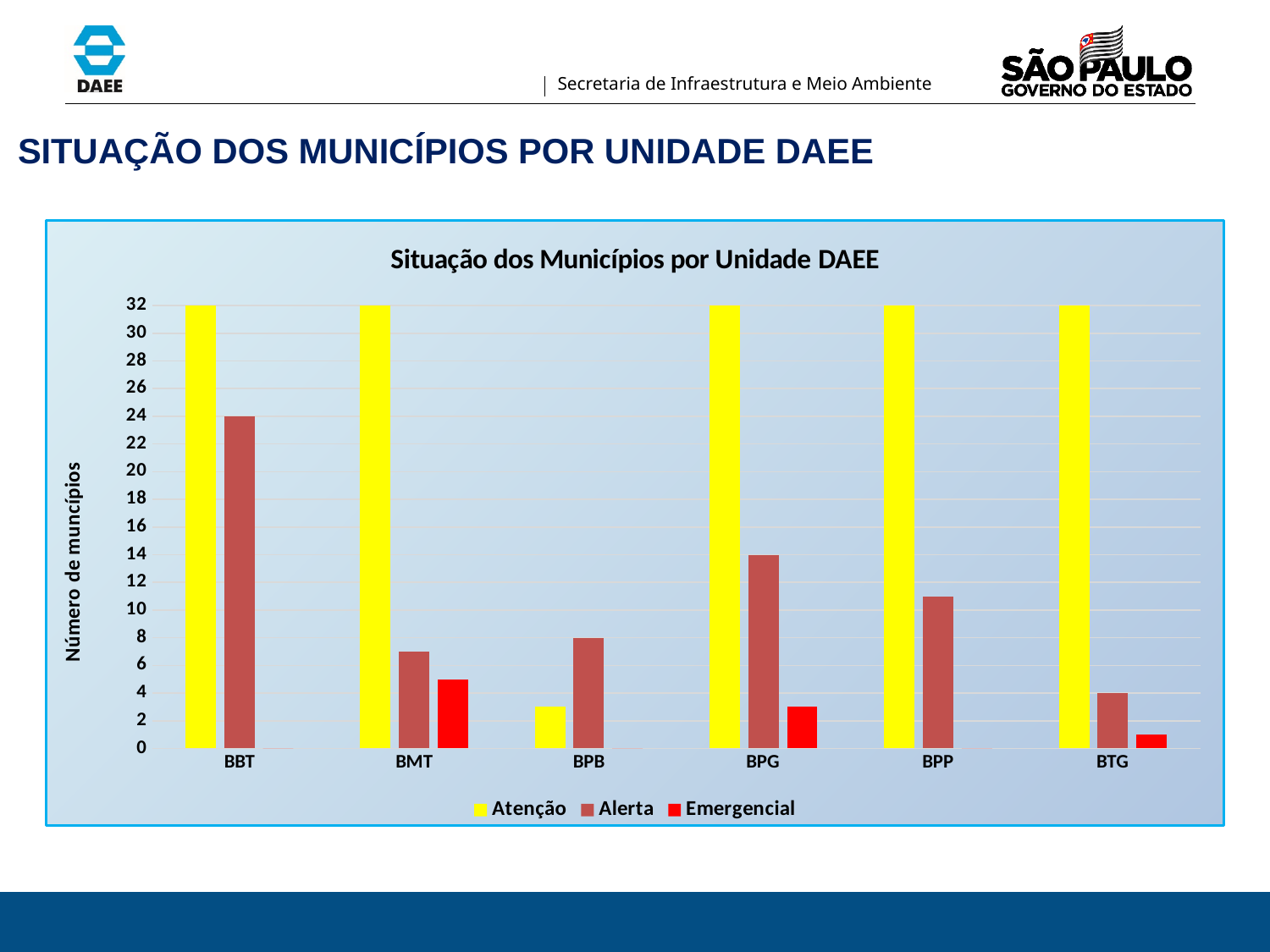
What are the three series named in the legend? Atenção, Alerta, Emergencial Which is larger, the Alerta value for BPG or the Alerta value for BPP? BPG Is the Emergencial value for BMT greater or less than 4? greater Which unit has the highest Alerta value? BBT Which unit has the lowest Atenção value? BPB How many DAEE units (categories) are shown on the x axis? 6 What kind of chart is shown on the slide? bar chart What is the title of the chart? Situação dos Municípios por Unidade DAEE Is the Alerta value for BPP greater or less than 10? greater How many series does the legend list? 3 Which unit has the highest Emergencial value? BMT